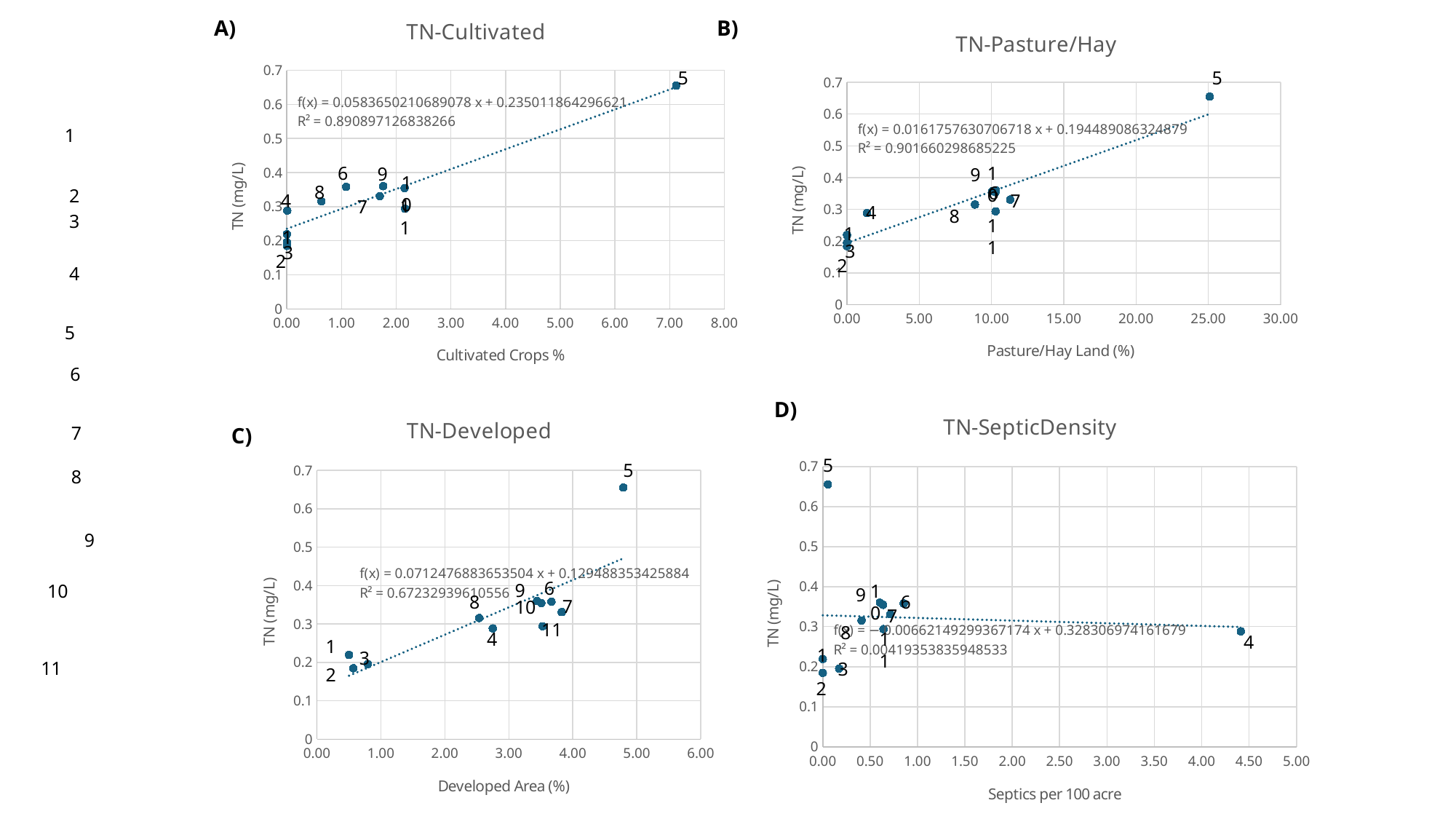
In the TN-SepticDensity chart, is the Septics per 100 acre value for point 4 greater or less than 4.00? greater In the TN-Pasture/Hay chart, is the Pasture/Hay Land (%) value for point 5 greater or less than 20.00? greater How many charts are shown on the slide? 4 What kind of chart is TN-Cultivated? scatter chart In the TN-Pasture/Hay chart, does the trendline rise or fall as Pasture/Hay Land (%) increases? rise In the TN-SepticDensity chart, does the trendline rise or fall as Septics per 100 acre increases? fall In the TN-Developed chart, which point has the higher TN value, point 5 or point 1? 5 What is the R² value printed on the TN-Pasture/Hay chart? 0.901660298685225 What is the x-axis label of the TN-Developed chart? Developed Area (%) In the TN-Cultivated chart, is the TN value for point 5 greater or less than 0.6? greater What is the R² value printed on the TN-Cultivated chart? 0.890897126838266 In the TN-Cultivated chart, which labelled point has the highest TN value? 5